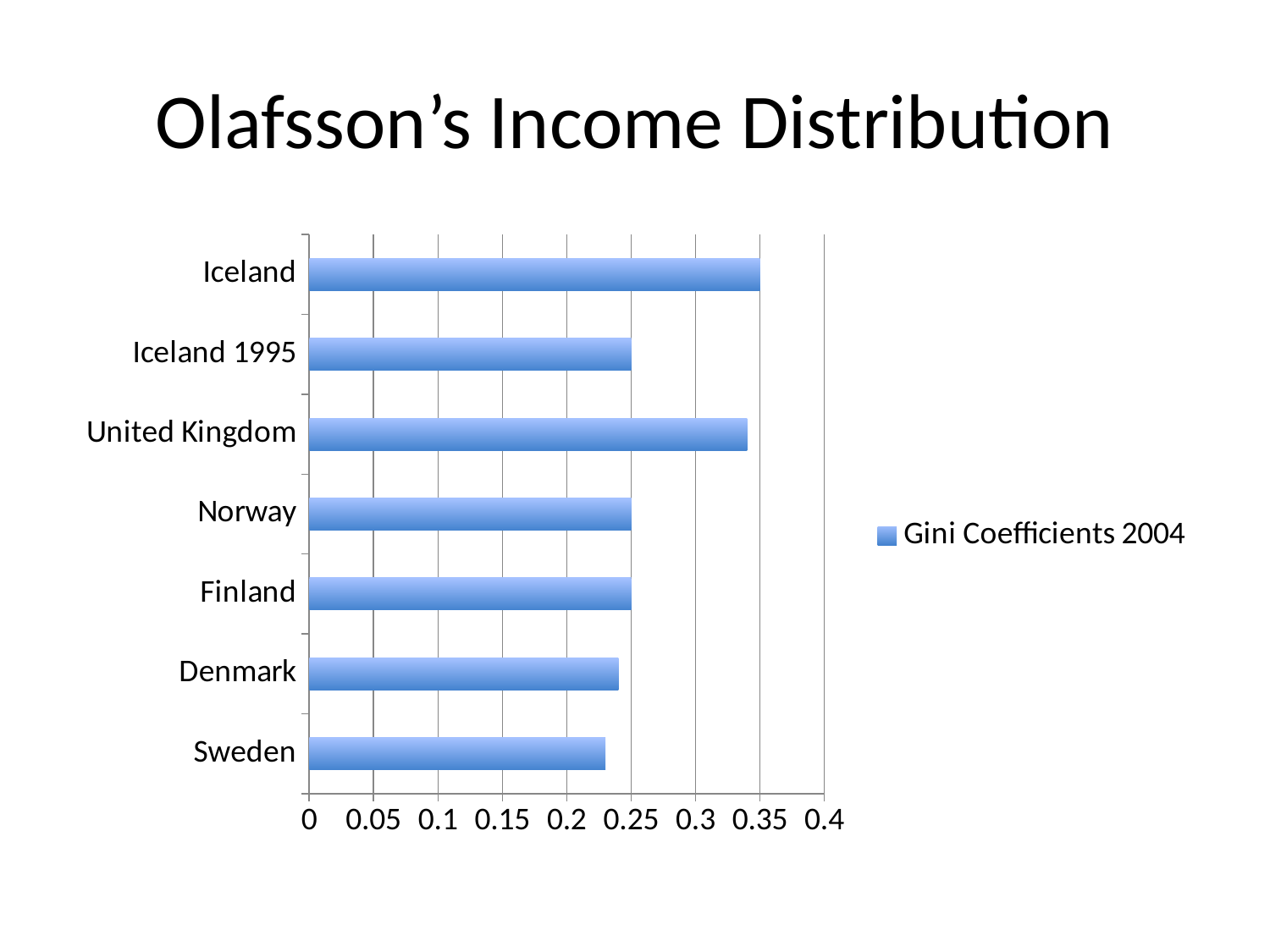
Which category has the highest Gini coefficient in the chart? Iceland What kind of chart is shown on the slide? Bar chart Which has a larger Gini coefficient, Iceland or Iceland 1995? Iceland What is the Gini coefficient value shown for Norway? 0.25 Is the value for United Kingdom greater or less than 0.3? greater Which category has the lowest Gini coefficient in the chart? Sweden What is the Gini coefficient value shown for Iceland 1995? 0.25 Is the value for Denmark greater or less than 0.25? less What is the difference between the Gini coefficient for Iceland and for Iceland 1995? 0.1 What is the Gini coefficient value shown for Iceland? 0.35 How many series does the legend list? 1 How many categories are shown in the chart? 7